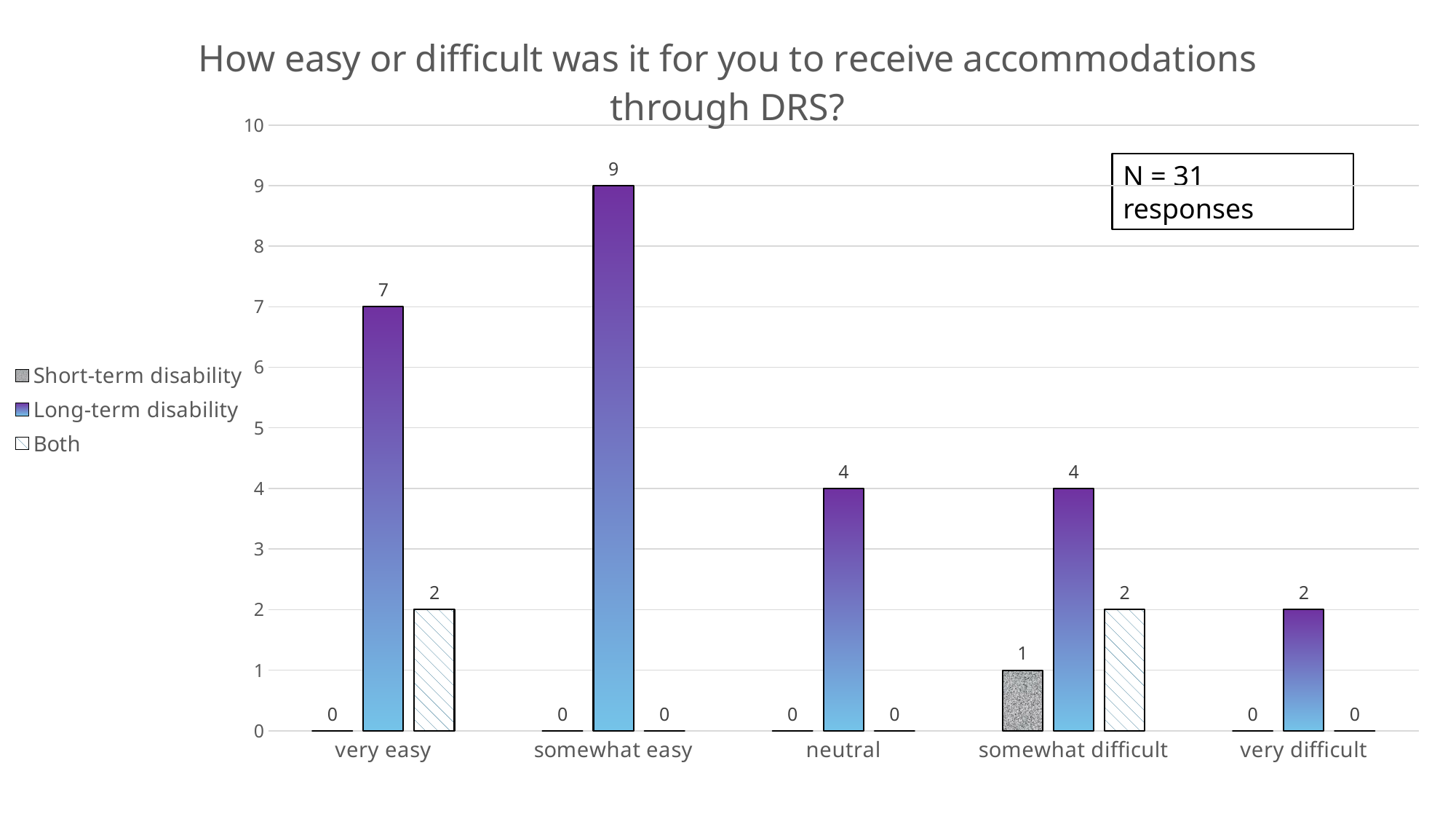
What is the value for Long-term disability in the very difficult category? 2 What kind of chart is shown on the slide? bar chart How many categories are shown on the x axis? 5 Which category has the highest Long-term disability value? somewhat easy What is the value for Long-term disability in the somewhat easy category? 9 Which category has the lowest Long-term disability value? very difficult How many series does the legend list? 3 Which is larger: the Long-term disability value for neutral or for very difficult? neutral What is the value for Short-term disability in the somewhat difficult category? 1 How many responses does the text box on the chart say there were? 31 What is the difference between the Long-term disability values for somewhat easy and very easy? 2 What is the value for Both in the very easy category? 2